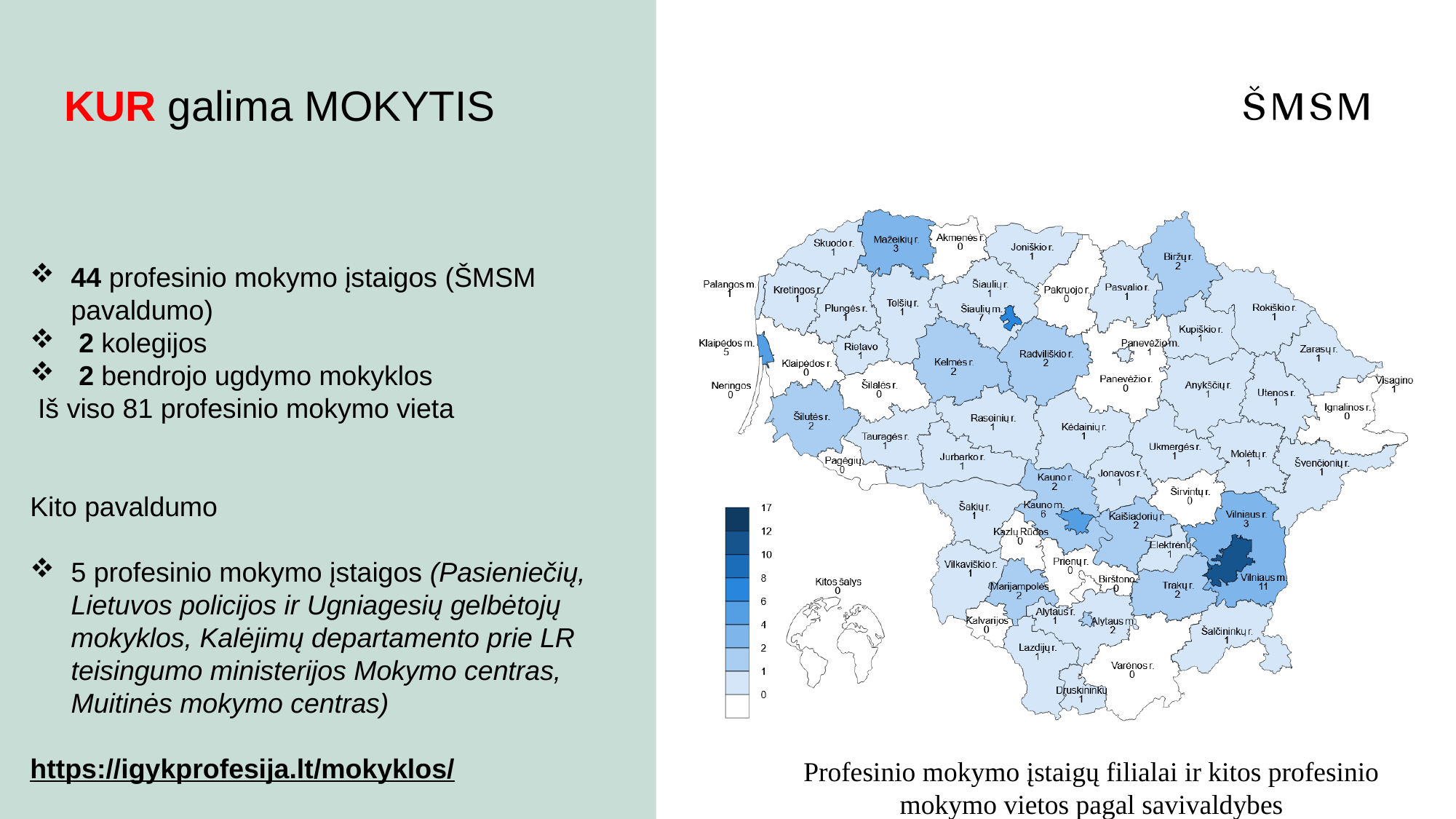
What is the value shown for Kauno m. on the map? 6 What is the value shown for Šiaulių m. on the map? 7 What is the value shown for Akmenės r. on the map? 0 What is the highest value shown on the map's colour legend? 17 What is the value shown for Klaipėdos m. on the map? 5 What type of chart is shown on the right side of the slide? Map (choropleth map) Which municipality has the highest value on the map? Vilniaus m. What is the value shown for Vilniaus m. on the map? 11 What is the value shown for Mažeikių r. on the map? 3 Which has a larger value on the map, Šiaulių m. or Klaipėdos m.? Šiaulių m. What is the difference between the values for Vilniaus m. and Kauno m. on the map? 5 What is the title of the map on the slide? Profesinio mokymo įstaigų filialai ir kitos profesinio mokymo vietos pagal savivaldybes